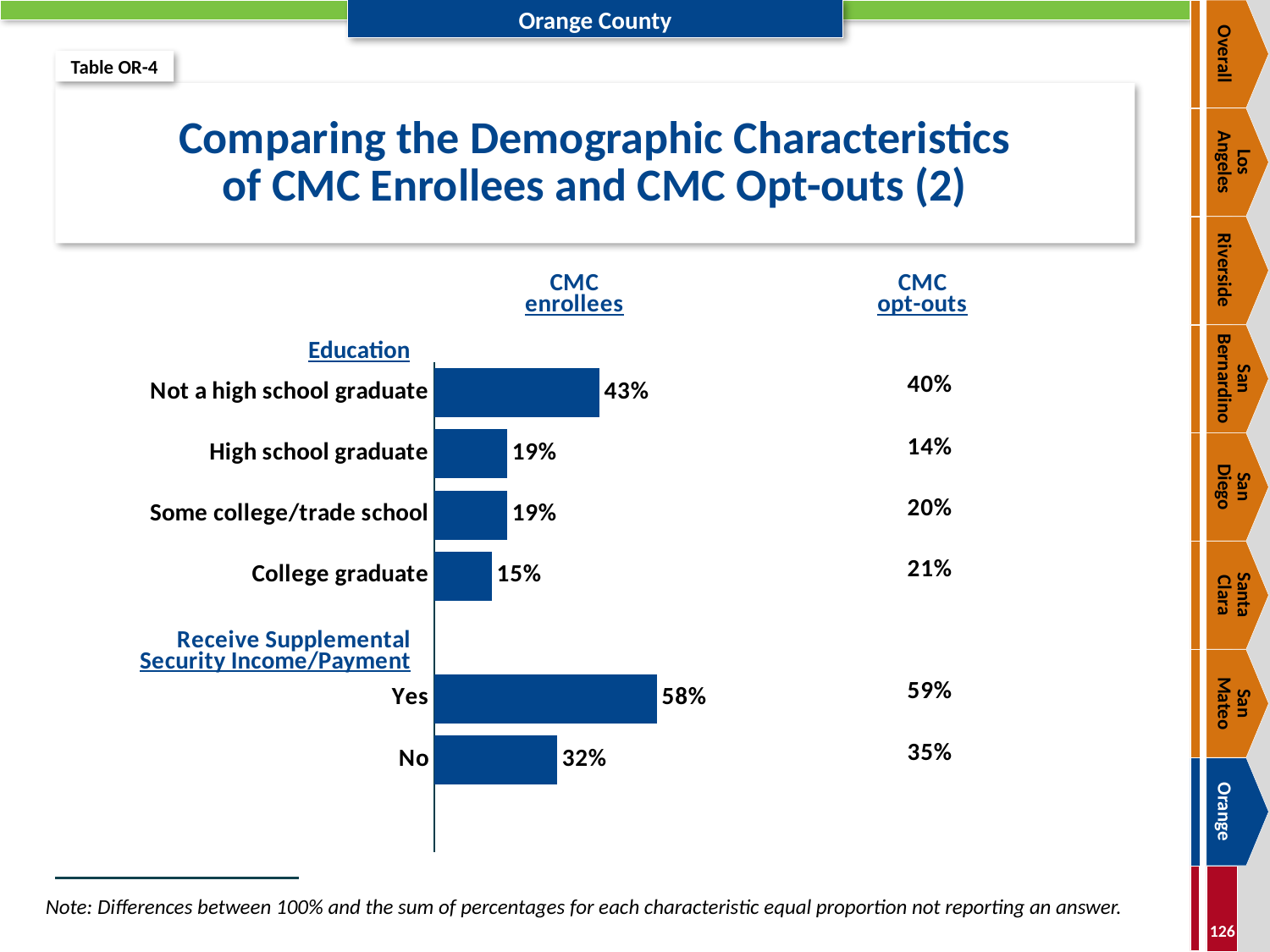
What percentage of CMC enrollees are college graduates? 15% Among the education categories, which has the lowest percentage of CMC enrollees? College graduate What is the title of the slide's chart? Comparing the Demographic Characteristics of CMC Enrollees and CMC Opt-outs (2) What percentage of CMC enrollees are not a high school graduate? 43% What is the difference between the percentage of CMC enrollees and CMC opt-outs who are college graduates? 6% Which is larger: the percentage of CMC enrollees who are not a high school graduate, or the percentage of CMC opt-outs who are not a high school graduate? CMC enrollees What type of chart is used to show the CMC enrollees percentages? Bar chart What is the difference between the percentage of CMC enrollees who receive Supplemental Security Income/Payment (Yes) and those who do not (No)? 26% What percentage of CMC opt-outs are high school graduates? 14% Among the education categories, which has the highest percentage of CMC enrollees? Not a high school graduate What percentage of CMC enrollees receive Supplemental Security Income/Payment (Yes)? 58% How many categories are shown as bars in the CMC enrollees chart? 6